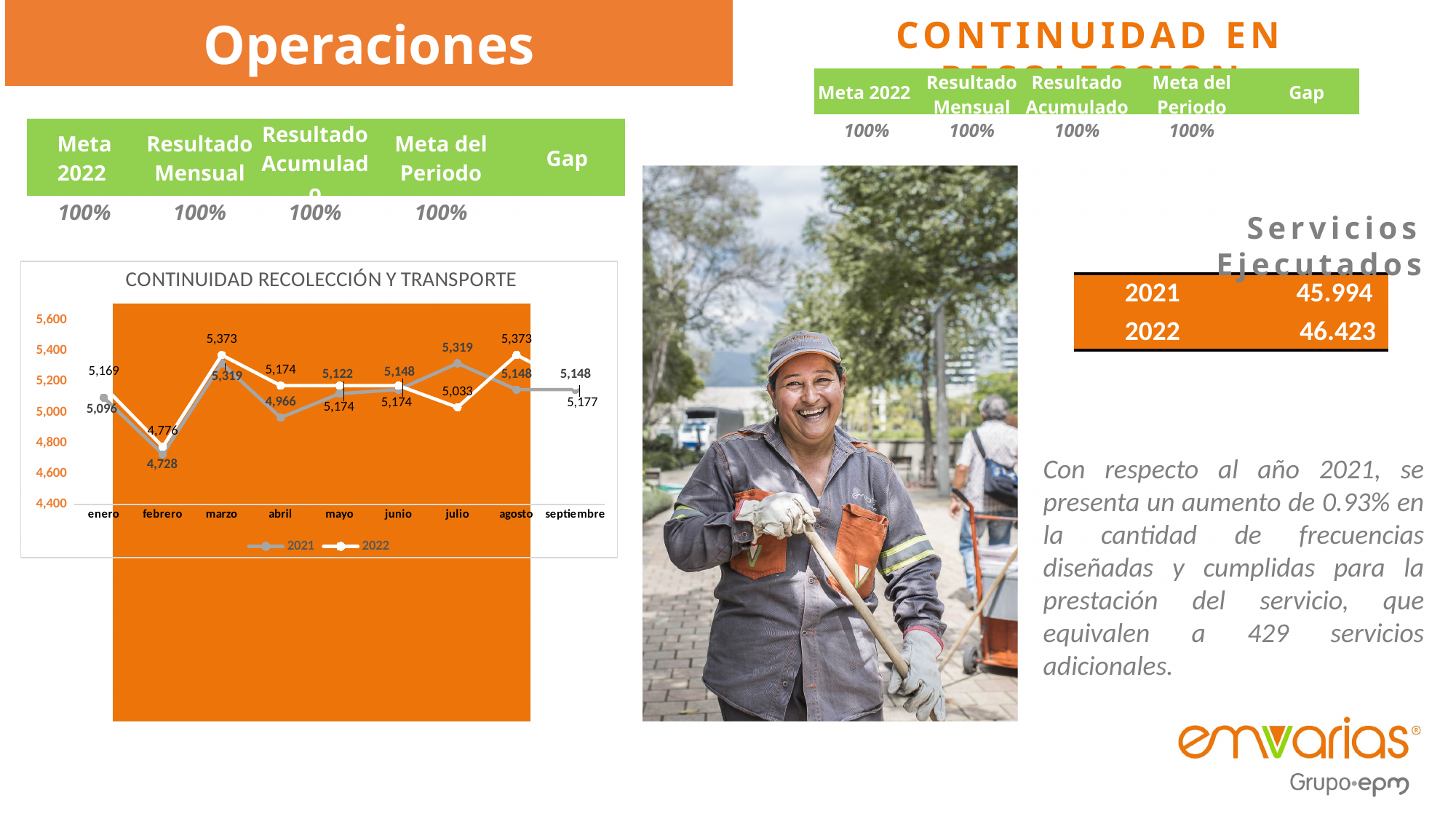
How many series does the legend of the CONTINUIDAD RECOLECCIÓN Y TRANSPORTE chart list? 2 In which month is the 2022 series lowest in the CONTINUIDAD RECOLECCIÓN Y TRANSPORTE chart? febrero In the CONTINUIDAD RECOLECCIÓN Y TRANSPORTE chart, which series has the higher value in julio, 2021 or 2022? 2021 What kind of chart is CONTINUIDAD RECOLECCIÓN Y TRANSPORTE? line chart What is the value for 2022 in julio in the CONTINUIDAD RECOLECCIÓN Y TRANSPORTE chart? 5,033 What is the value for 2022 in marzo in the CONTINUIDAD RECOLECCIÓN Y TRANSPORTE chart? 5,373 What is the value for 2021 in abril in the CONTINUIDAD RECOLECCIÓN Y TRANSPORTE chart? 4,966 How many months are shown on the x axis of the CONTINUIDAD RECOLECCIÓN Y TRANSPORTE chart? 9 In which month is the 2021 series lowest in the CONTINUIDAD RECOLECCIÓN Y TRANSPORTE chart? febrero What is the value for 2021 in septiembre in the CONTINUIDAD RECOLECCIÓN Y TRANSPORTE chart? 5,148 In the CONTINUIDAD RECOLECCIÓN Y TRANSPORTE chart, what is the difference between the 2022 and 2021 values in abril? 208 In the CONTINUIDAD RECOLECCIÓN Y TRANSPORTE chart, what is the difference between the 2022 and 2021 values in marzo? 54